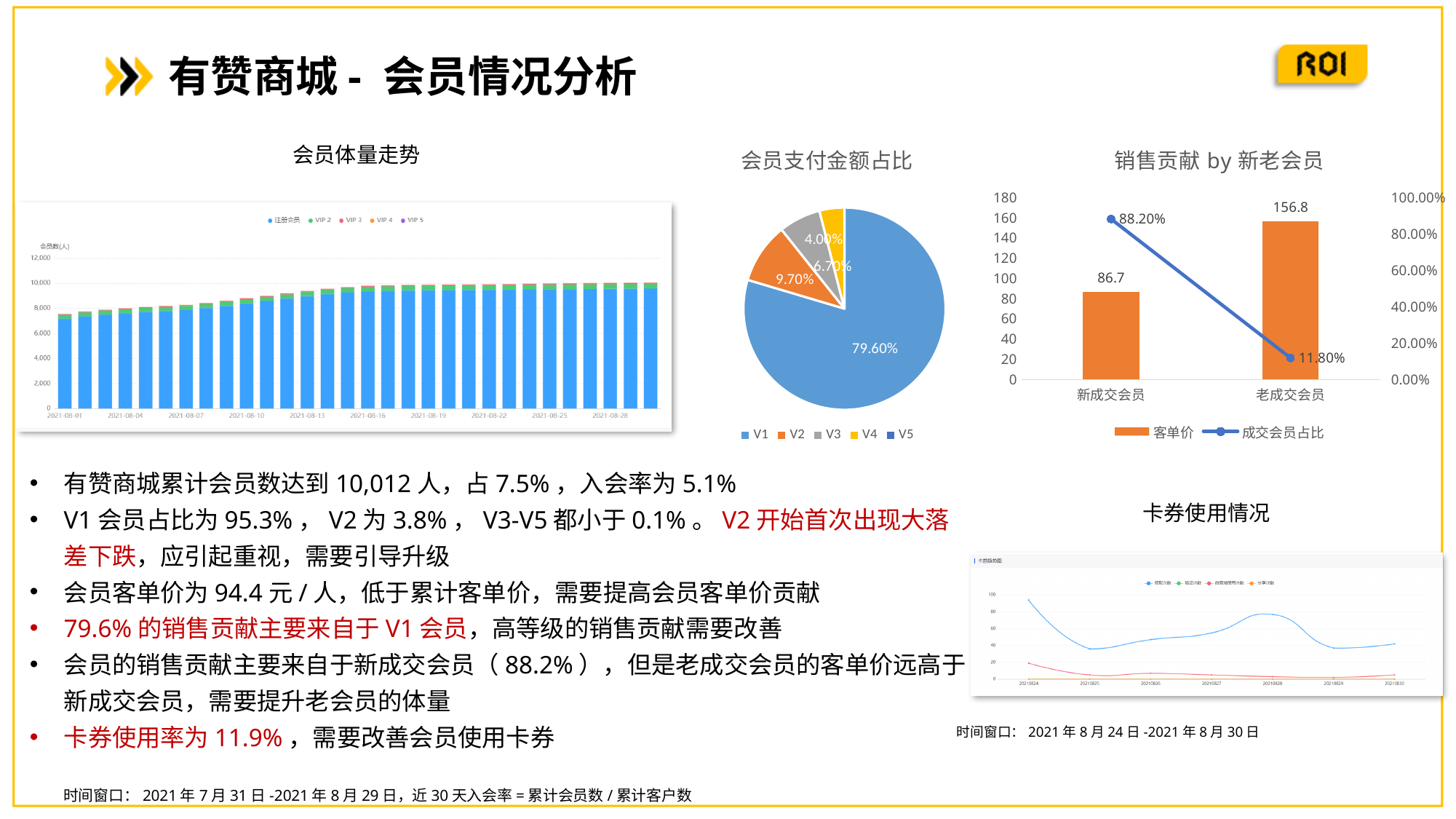
How many series does the legend of the 销售贡献 by 新老会员 chart list? 2 In the 会员支付金额占比 pie chart, what share does V2 have? 9.70% In the 销售贡献 by 新老会员 chart, what is the 成交会员占比 for 新成交会员? 88.20% In the 会员支付金额占比 pie chart, what share does V1 have? 79.60% In the 销售贡献 by 新老会员 chart, what is the 客单价 for 老成交会员? 156.8 In the 会员支付金额占比 pie chart, which category has the largest slice? V1 In the 会员体量走势 chart, do the bar heights rise or fall from 2021-08-01 to the end of the period? Rise In the 销售贡献 by 新老会员 chart, what is the difference in 客单价 between 老成交会员 and 新成交会员? 70.1 In the 会员支付金额占比 pie chart, what is the difference between the V2 and V3 shares? 3.00% What kind of chart is the 会员体量走势 chart? Stacked bar chart In the 销售贡献 by 新老会员 chart, which group has the higher 客单价, 新成交会员 or 老成交会员? 老成交会员 How many entries does the legend of the 会员支付金额占比 pie chart list? 5